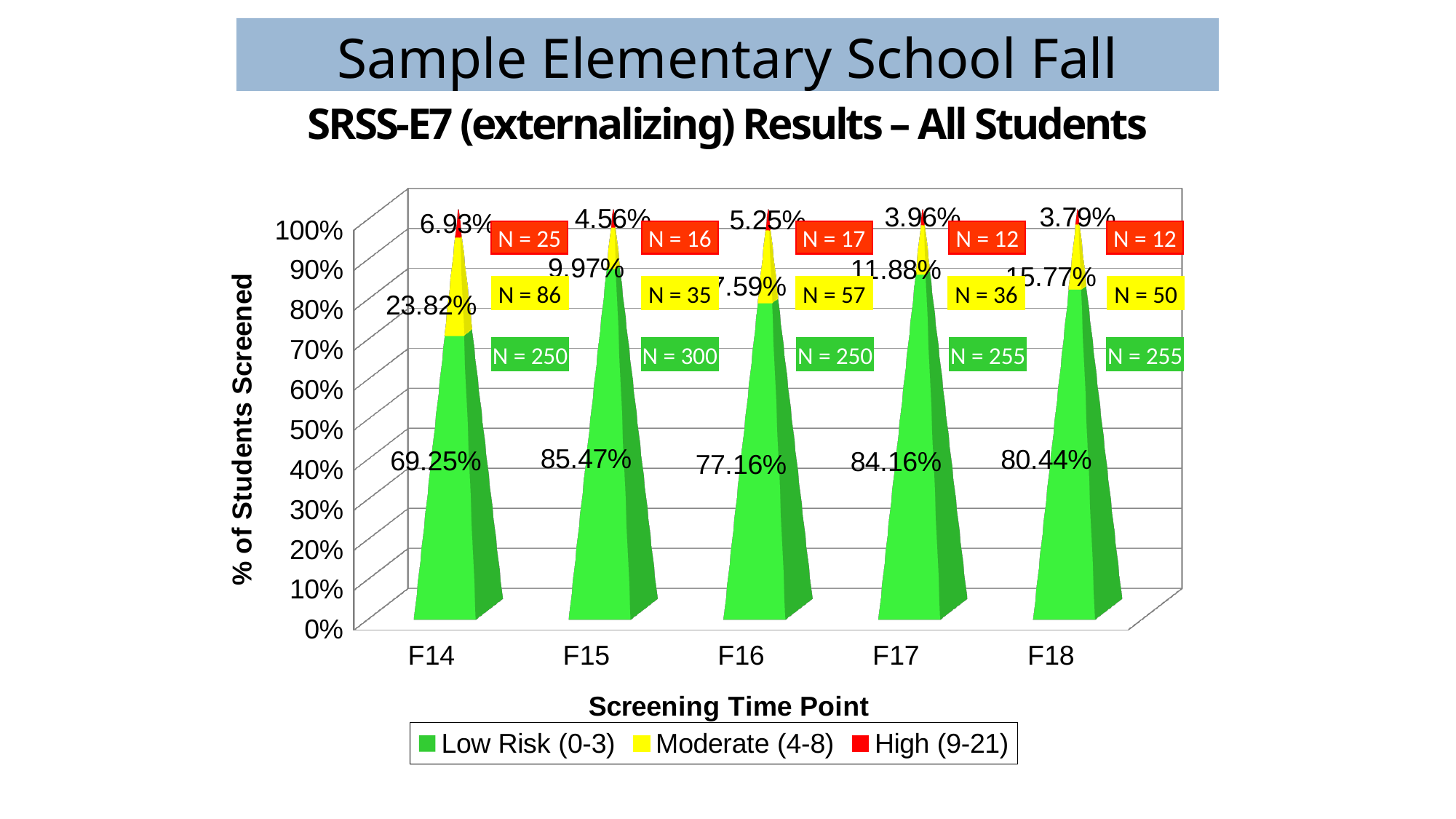
At which screening time point was the Low Risk (0-3) percentage lowest? F14 How many series does the legend list? 3 How many screening time points are shown on the x axis? 5 What percentage of students were High (9-21) at F17? 3.96% At which screening time point was the Low Risk (0-3) percentage highest? F15 What percentage of students were Low Risk (0-3) at F16? 77.16% What kind of chart is shown on the slide? Stacked bar chart What percentage of students were Moderate (4-8) at F18? 15.77% What percentage of students were Low Risk (0-3) at F14? 69.25% At which screening time point was the High (9-21) percentage highest? F14 Which is larger, the Moderate (4-8) percentage at F14 or at F15? F14 What is the difference between the Low Risk (0-3) percentages at F15 and F14? 16.22%